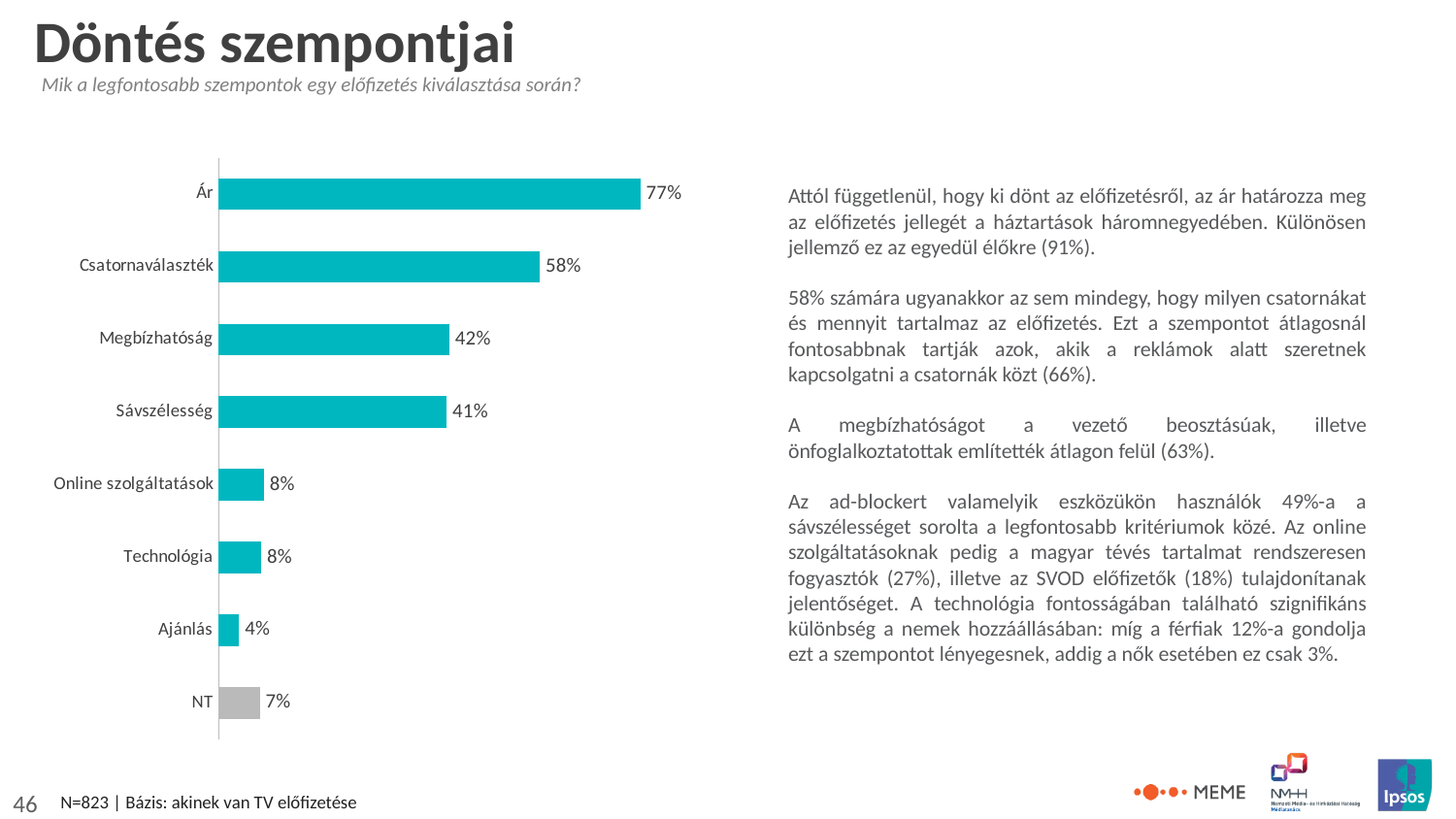
What is the value for Ajánlás? 4% What kind of chart is shown on the slide? Bar chart Which category has the highest value? Ár What is the difference between the values for Ár and Csatornaválaszték? 19% What is the value for Ár? 77% How many categories are shown in the chart? 8 What is the value for NT? 7% Which is larger, the value for Sávszélesség or the value for Online szolgáltatások? Sávszélesség What is the value for Megbízhatóság? 42% Which category has the lowest value? Ajánlás What is the title of the slide containing the chart? Döntés szempontjai What is the value for Csatornaválaszték? 58%